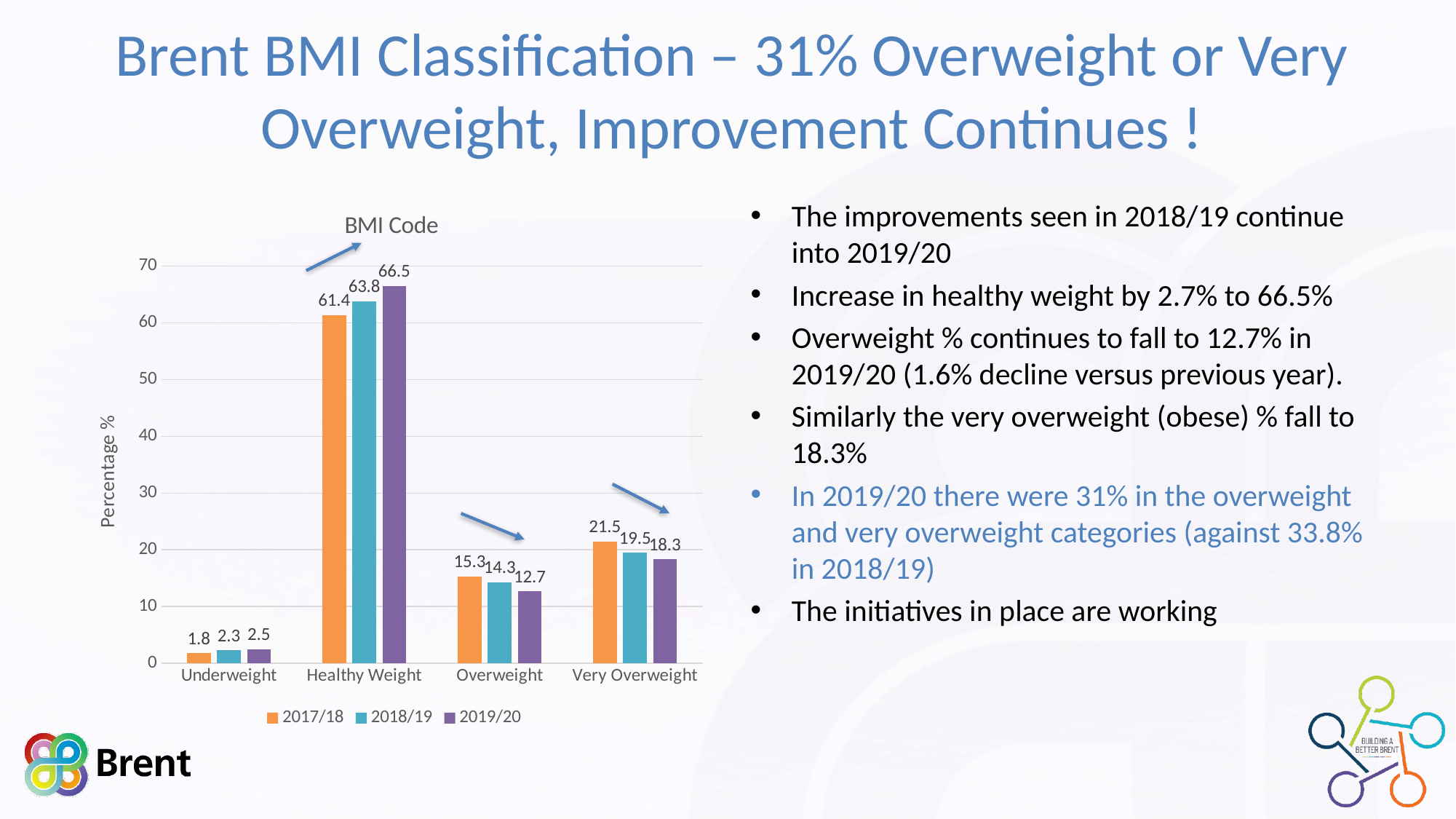
What is the difference between the Very Overweight values for 2017/18 and 2019/20? 3.2 What is the value for Overweight in 2017/18? 15.3 Which is larger, the Overweight value for 2018/19 or the Very Overweight value for 2019/20? Very Overweight 2019/20 Which category has the lowest value in 2017/18? Underweight What is the title of the chart? BMI Code How many series does the legend list? 3 What kind of chart is shown? Bar chart Do the Overweight values rise or fall from 2017/18 to 2019/20? Fall Which category has the highest value in 2019/20? Healthy Weight How many categories are shown on the x axis? 4 What is the value for Healthy Weight in 2019/20? 66.5 What is the value for Underweight in 2018/19? 2.3